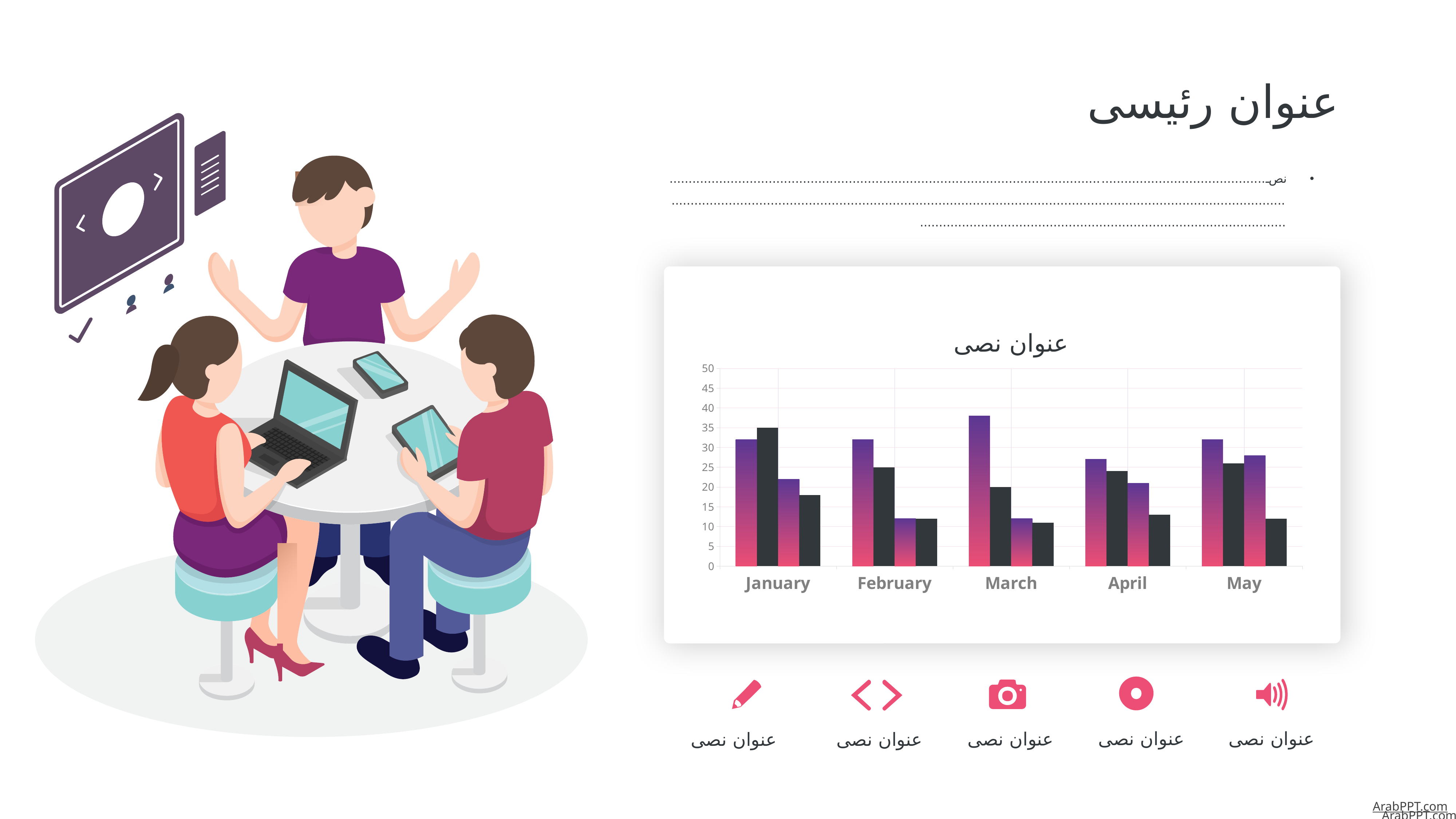
What kind of chart is shown on the slide? bar chart What is the highest value shown on the chart's vertical axis? 50 Is the first (leftmost) bar for April greater or less than 30? less How many categories are shown on the x axis of the chart? 5 Which month contains the tallest bar in the chart? March Which is larger: the fourth (rightmost) bar for January or the fourth (rightmost) bar for May? January Is the first (leftmost) bar for March greater or less than 35? greater Is the fourth (rightmost) bar for February greater or less than 15? less How many bars are plotted for each month in the chart? 4 Which is larger: the first (leftmost) bar for March or the first (leftmost) bar for January? March